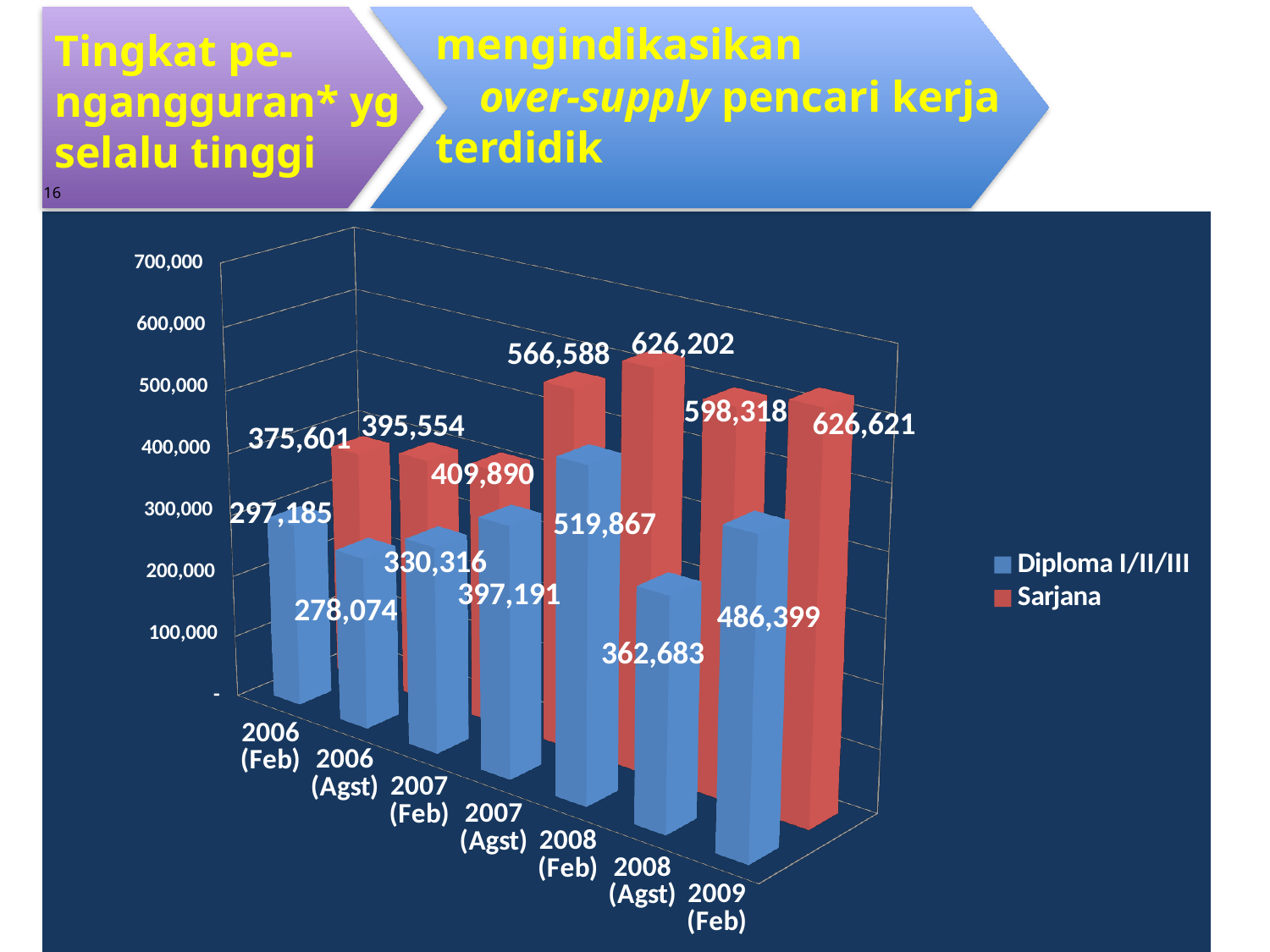
What is the value for Sarjana in 2007 (Agst)? 566,588 In which period is the Diploma I/II/III value lowest? 2006 (Agst) Which is larger: the Diploma I/II/III value in 2008 (Feb) or in 2008 (Agst)? 2008 (Feb) What is the difference between the Sarjana and Diploma I/II/III values in 2009 (Feb)? 140,222 What is the value for Diploma I/II/III in 2008 (Feb)? 519,867 How many periods are shown on the x axis? 7 What is the value for Sarjana in 2009 (Feb)? 626,621 In which period is the Sarjana value lowest? 2006 (Feb) How many series does the legend list? 2 In which period is the Diploma I/II/III value highest? 2008 (Feb) What kind of chart is shown on the slide? Bar chart What is the value for Diploma I/II/III in 2006 (Agst)? 278,074